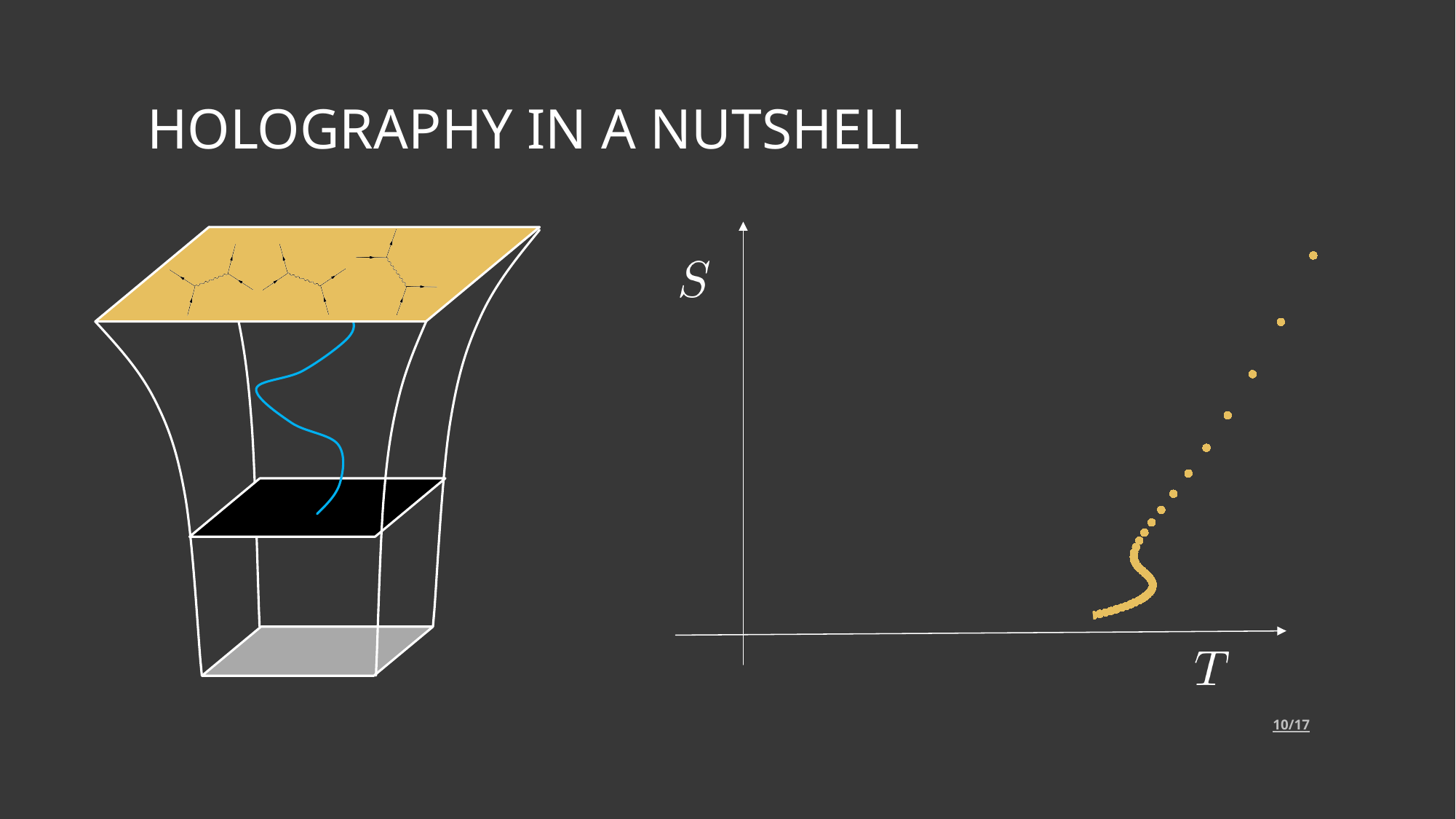
What label is shown on the vertical axis of the chart on the right? S What kind of chart is shown on the right side of the slide? scatter chart What label is shown on the horizontal axis of the chart on the right? T In the chart on the right, do the plotted points overall rise or fall as T increases along the x axis? rise